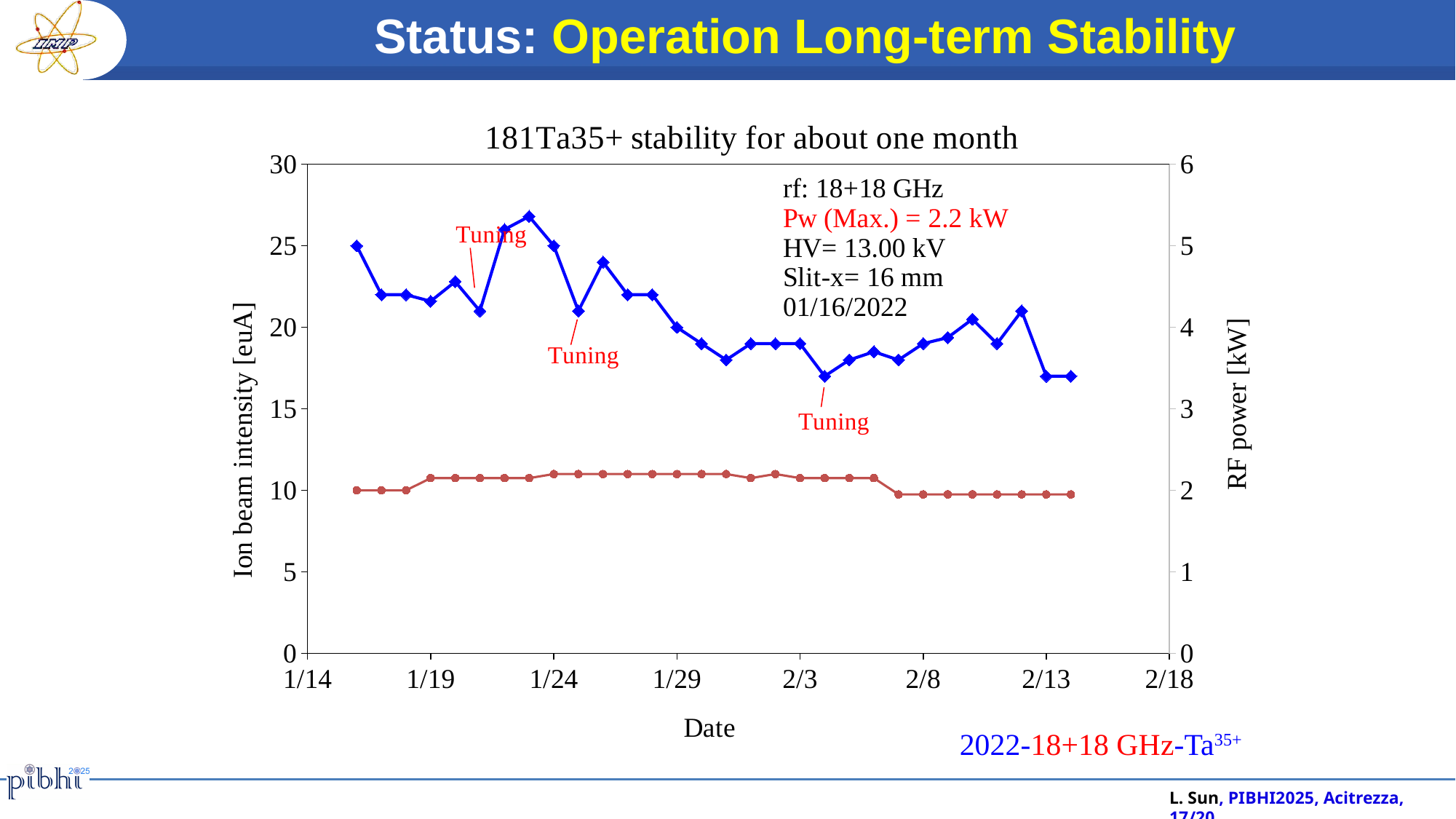
What is the label of the left vertical axis? Ion beam intensity [euA] Is the ion beam intensity at the first plotted point greater or less than 20 euA? greater According to the text on the chart, what is the HV value? 13.00 kV What type of chart is shown on the slide? line chart Overall, does the ion beam intensity rise or fall from the start to the end of the period? fall How many 'Tuning' annotations are marked on the chart? 3 Is the ion beam intensity at the last plotted point greater or less than 20 euA? less How many data series are plotted on the chart? 2 Is the RF power at any point greater or less than 3 kW? less According to the text on the chart, what is the maximum RF power (Pw)? 2.2 kW What is the title of the chart? 181Ta35+ stability for about one month